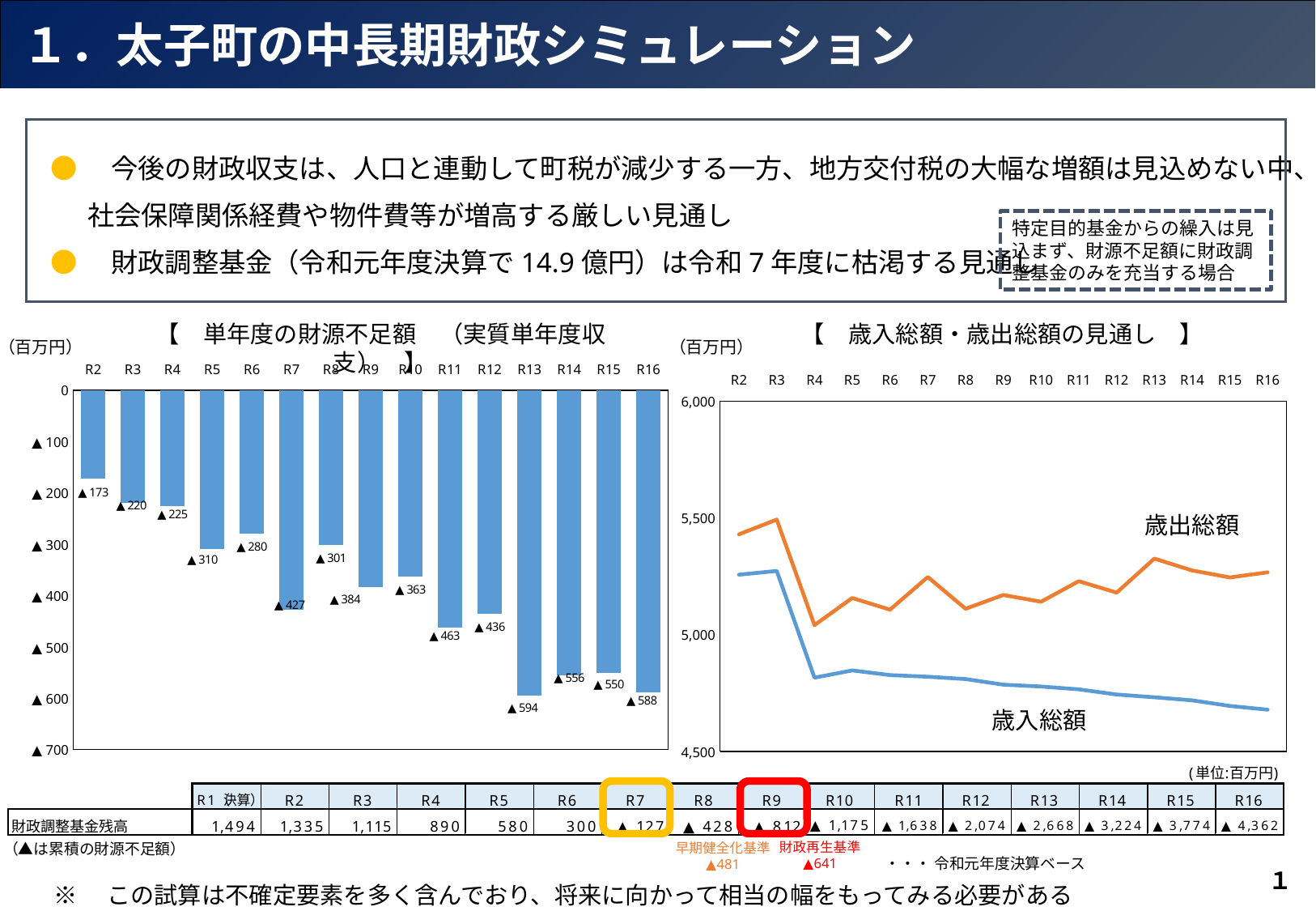
How many years (categories) are plotted in the left bar chart (単年度の財源不足額)? 15 In the left bar chart (単年度の財源不足額), which year has the larger shortfall, R7 or R8? R7 In the left bar chart (単年度の財源不足額), what is the value shown for R7? ▲427 In the left bar chart (単年度の財源不足額), which year has the smallest shortfall? R2 In the left bar chart (単年度の財源不足額), which year has the largest shortfall? R13 In the right line chart (歳入総額・歳出総額の見通し), is the value of 歳出総額 at R13 greater or less than 5,000? greater In the right line chart (歳入総額・歳出総額の見通し), is the value of 歳入総額 at R16 greater or less than 5,000? less In the left bar chart (単年度の財源不足額), by how much (in 百万円) does the shortfall in R13 exceed the shortfall in R2? 421 How many series are plotted in the right line chart (歳入総額・歳出総額の見通し)? 2 What kind of chart is the left chart (単年度の財源不足額)? Bar chart In the left bar chart (単年度の財源不足額), what is the value shown for R16? ▲588 In the left bar chart (単年度の財源不足額), what is the value shown for R2? ▲173